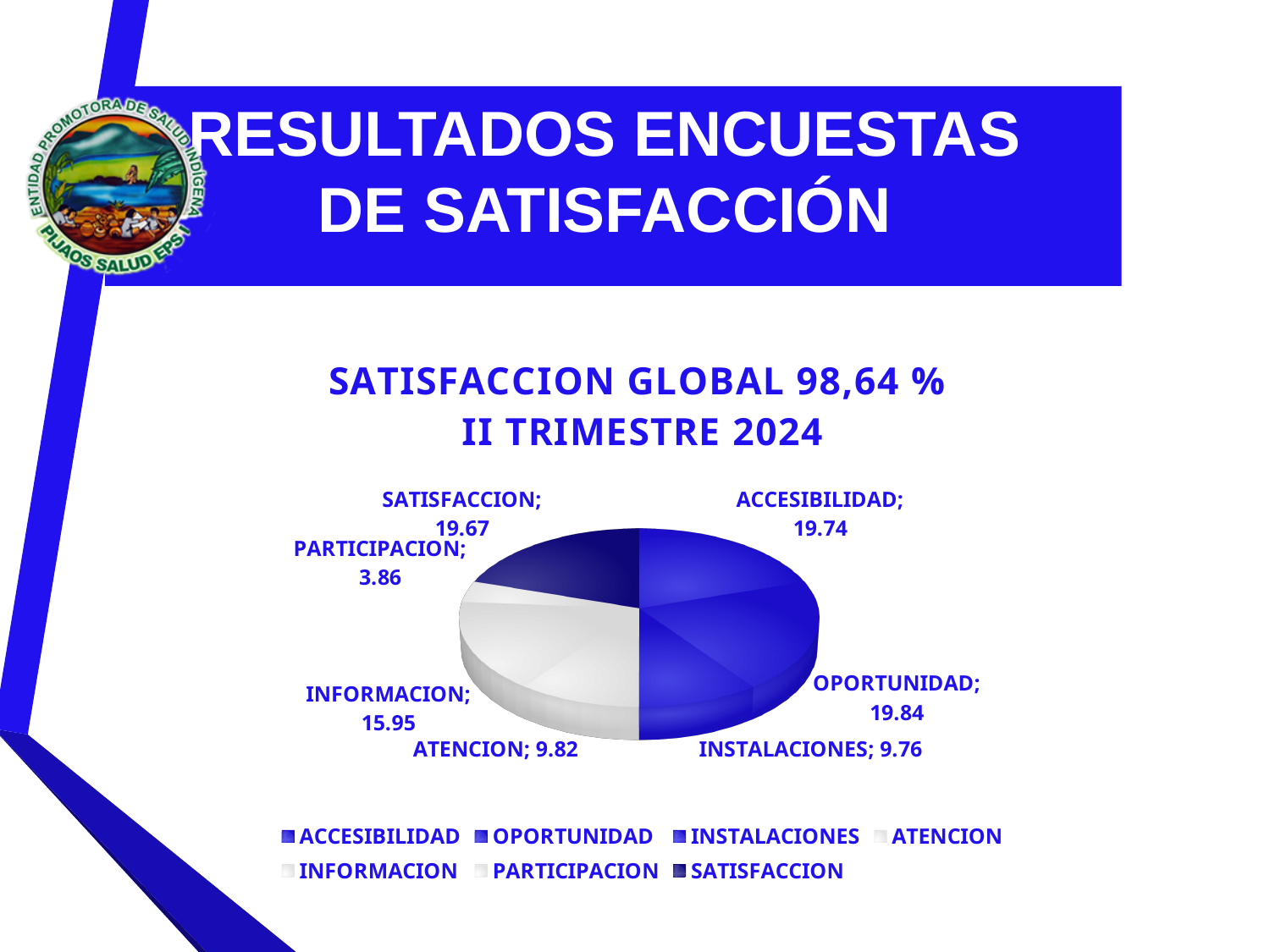
What is the value shown for INFORMACION in the pie chart? 15.95 What kind of chart is shown on the slide? Pie chart What is the difference between the values for OPORTUNIDAD and INSTALACIONES? 10.08 What is the title of the chart on the slide? SATISFACCION GLOBAL 98,64 % II TRIMESTRE 2024 What is the value shown for OPORTUNIDAD in the pie chart? 19.84 What is the difference between the values for ACCESIBILIDAD and PARTICIPACION? 15.88 Which is larger in the pie chart, INFORMACION or ATENCION? INFORMACION What is the value shown for INSTALACIONES in the pie chart? 9.76 What is the value shown for PARTICIPACION in the pie chart? 3.86 How many categories are shown in the pie chart? 7 How many entries does the legend of the pie chart list? 7 Which category has the smallest slice in the pie chart? PARTICIPACION